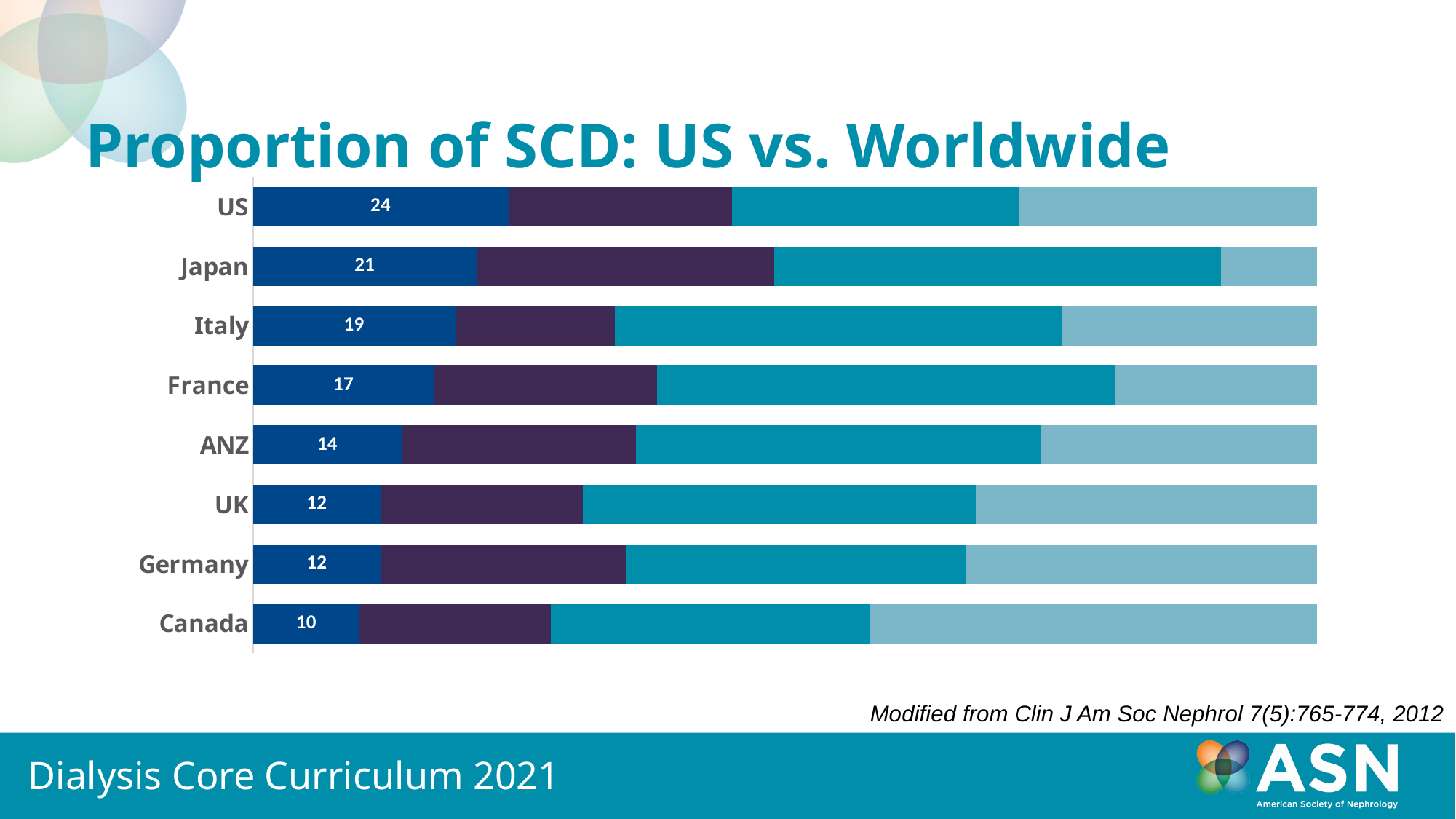
What is the labelled value for Japan in the first (dark blue) segment? 21 Which country has the lowest labelled value in the first (dark blue) segment? Canada What is the labelled value for Canada in the first (dark blue) segment? 10 Do the labelled values rise or fall going from the top bar (US) to the bottom bar (Canada)? Fall What is the title of the chart? Proportion of SCD: US vs. Worldwide What is the labelled value for France in the first (dark blue) segment? 17 What is the labelled value for the US in the first (dark blue) segment? 24 What is the difference between the labelled values for the US and Canada? 14 Which has the larger labelled value, Italy or ANZ? Italy How many countries are shown on the chart? 8 What kind of chart is shown on the slide? Stacked bar chart Which country has the highest labelled value in the first (dark blue) segment? US